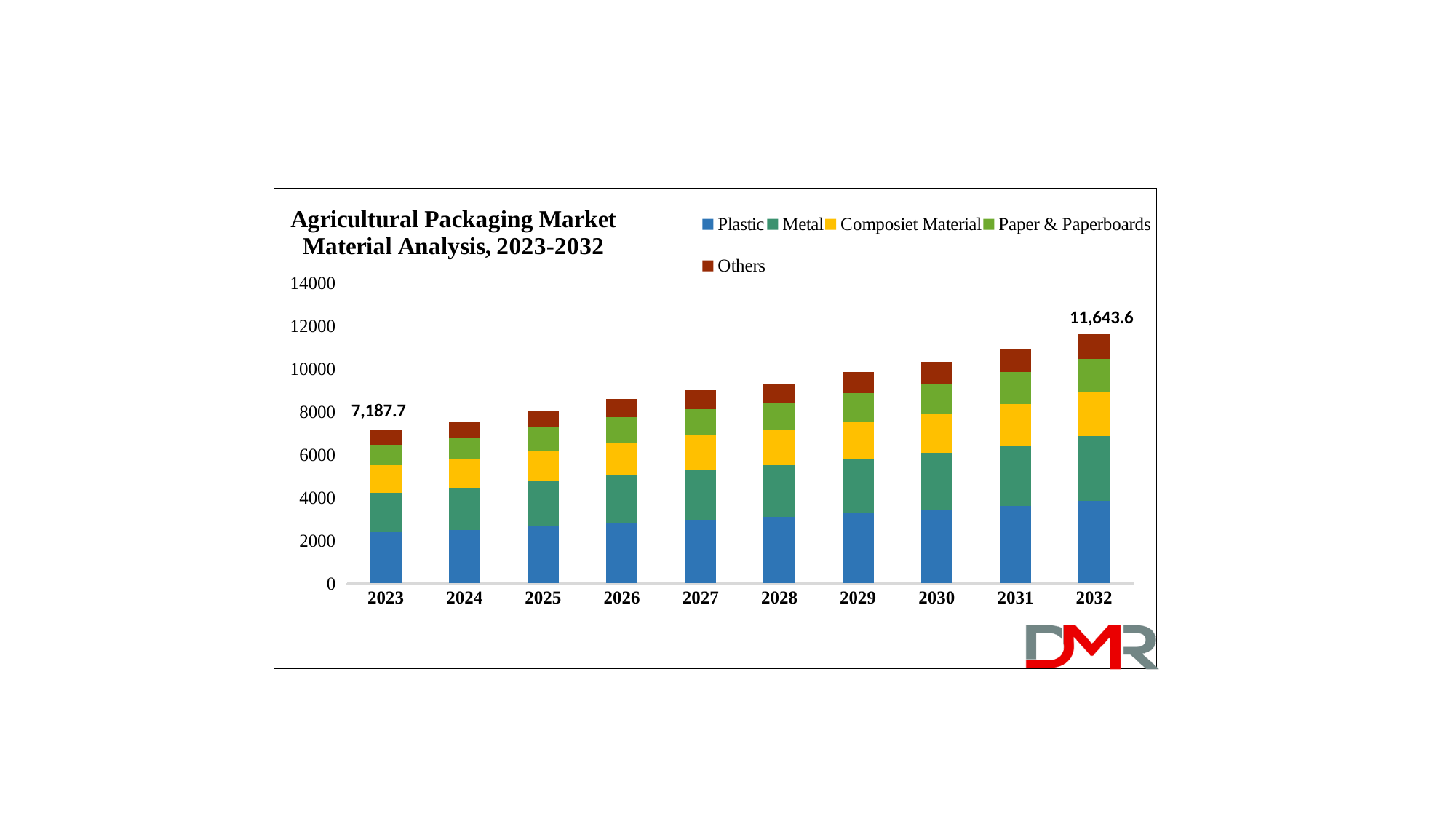
What is the title of the chart? Agricultural Packaging Market Material Analysis, 2023-2032 How many years are shown on the x axis? 10 What is the total value shown for 2032? 11,643.6 Which year has the lowest total bar? 2023 Which year has the highest total bar? 2032 What is the difference between the 2032 total and the 2023 total? 4,455.9 What is the total value shown for 2023? 7,187.7 What kind of chart is shown on the slide? Stacked bar chart Is the total bar for 2031 larger or smaller than the total bar for 2025? Larger Do the total bar heights rise or fall from 2023 to 2032? Rise Is the total value for 2026 greater or less than 8000? greater How many series does the legend list? 5